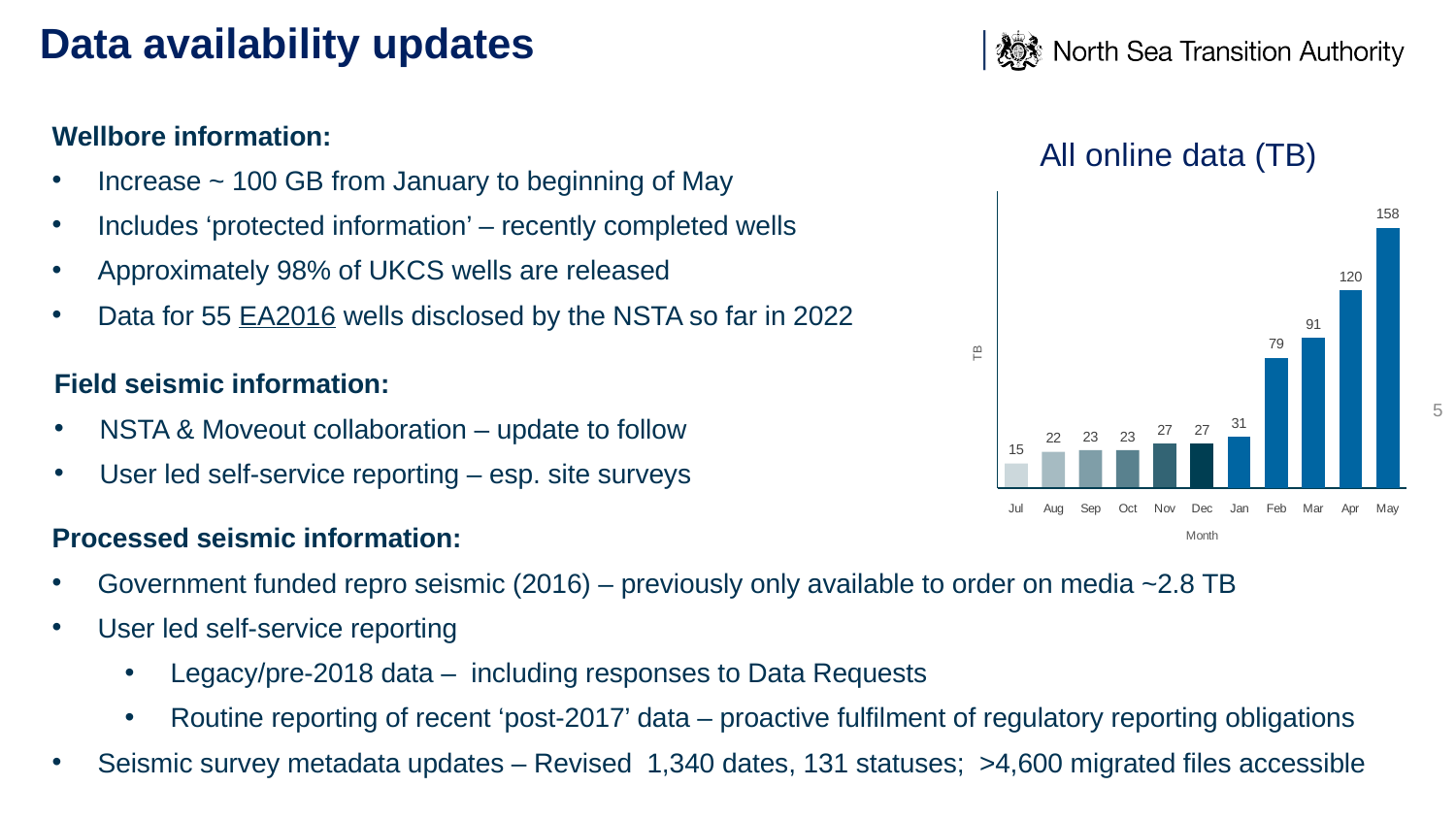
Do the values in the 'All online data (TB)' chart generally rise or fall from Jul to May? Rise Which month has the lowest value in the 'All online data (TB)' chart? Jul What is the difference between the values for Feb and Jan in the 'All online data (TB)' chart? 48 How many months are shown in the 'All online data (TB)' chart? 11 What kind of chart is the 'All online data (TB)' chart? Bar chart Which month has the highest value in the 'All online data (TB)' chart? May Which is larger in the 'All online data (TB)' chart, the value for Mar or the value for Apr? Apr What is the value for May in the 'All online data (TB)' chart? 158 What is the value for Jul in the 'All online data (TB)' chart? 15 What is the difference between the values for May and Apr in the 'All online data (TB)' chart? 38 What is the label on the x axis of the 'All online data (TB)' chart? Month What is the value for Feb in the 'All online data (TB)' chart? 79